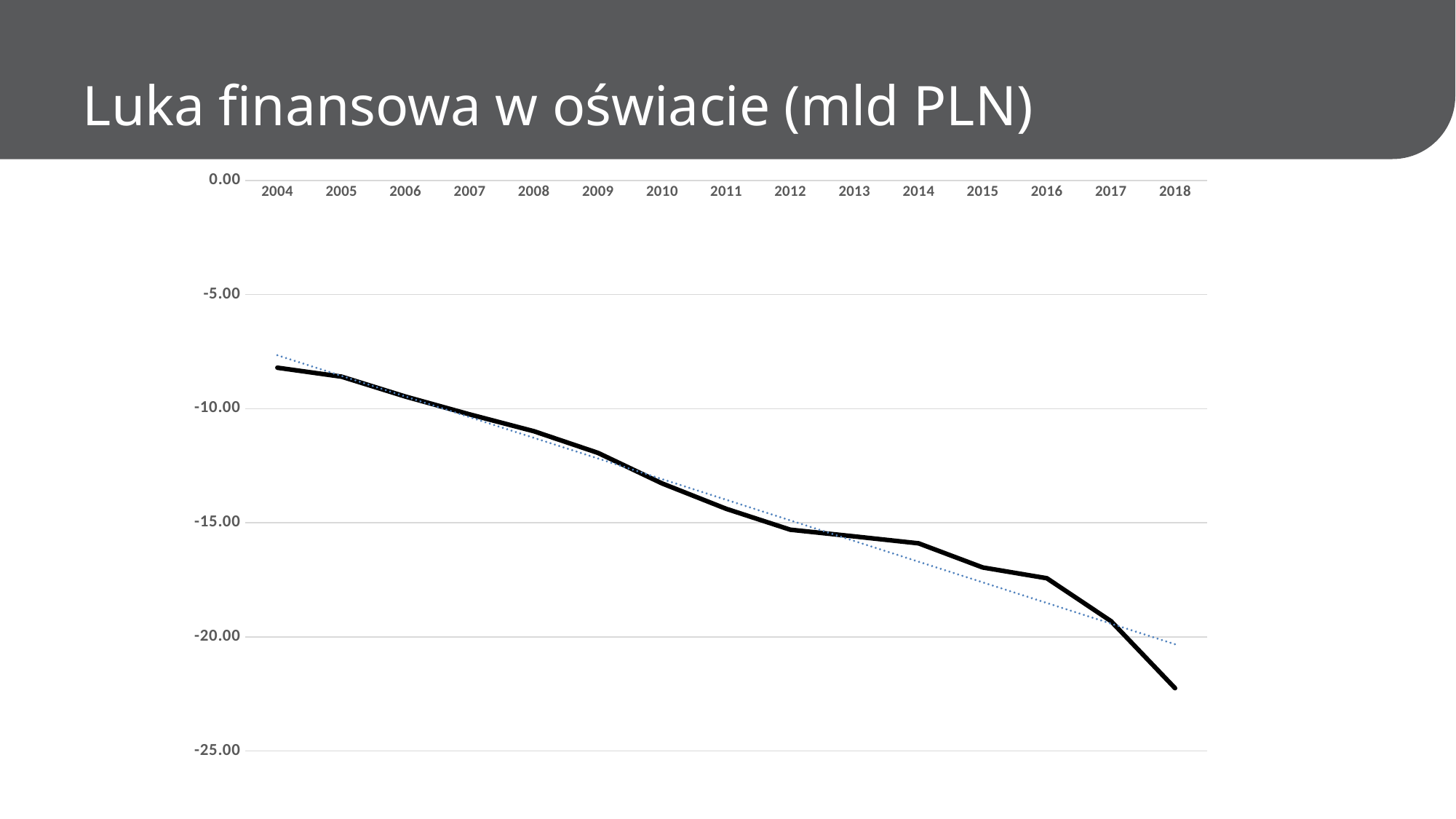
Is the value for 2016 greater or less than -15.00? less What is the title of the slide? Luka finansowa w oświacie (mld PLN) Which year has the highest value? 2004 How many years are plotted along the x axis? 15 Do the values rise or fall from 2004 to 2018? fall What kind of chart is shown on the slide? line chart Is the value for 2018 greater or less than -20.00? less Is the value for 2004 greater or less than -10.00? greater Which is larger, the value for 2010 or the value for 2016? 2010 What is the first year shown on the x axis? 2004 Which year has the lowest value? 2018